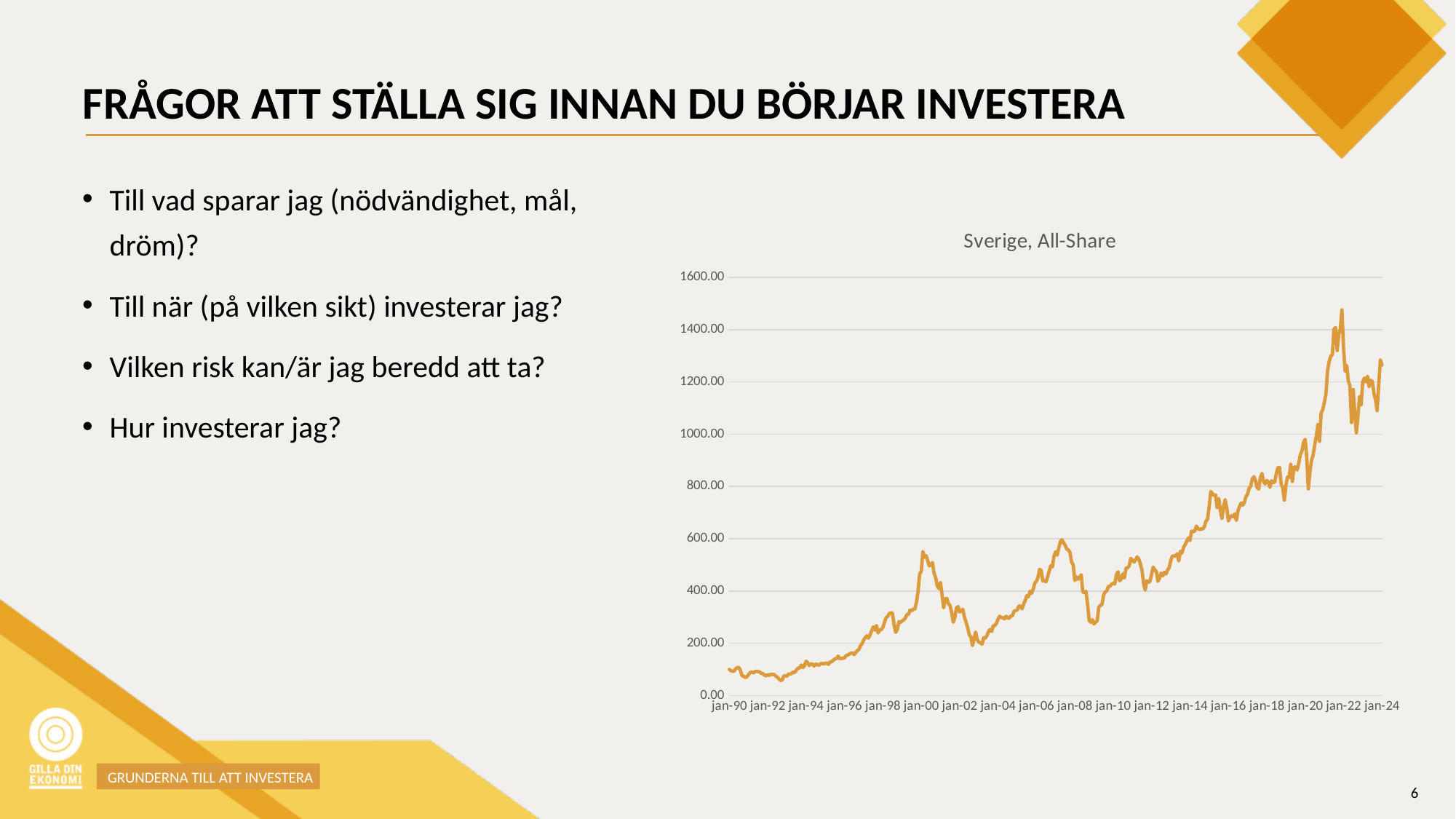
How many date labels are shown on the x axis? 18 Is the value at jan-24 greater or less than 1000.00? greater Is the value at jan-16 greater or less than 600.00? greater Is the highest point reached by the line greater or less than 1400.00? greater Overall, do the values in the chart rise or fall from jan-90 to jan-24? rise What is the title of the chart? Sverige, All-Share What is the highest value shown on the y axis? 1600.00 Which is larger, the value at jan-90 or the value at jan-24? jan-24 What kind of chart is shown on the slide? line chart Which is larger, the value at jan-00 or the value at jan-20? jan-20